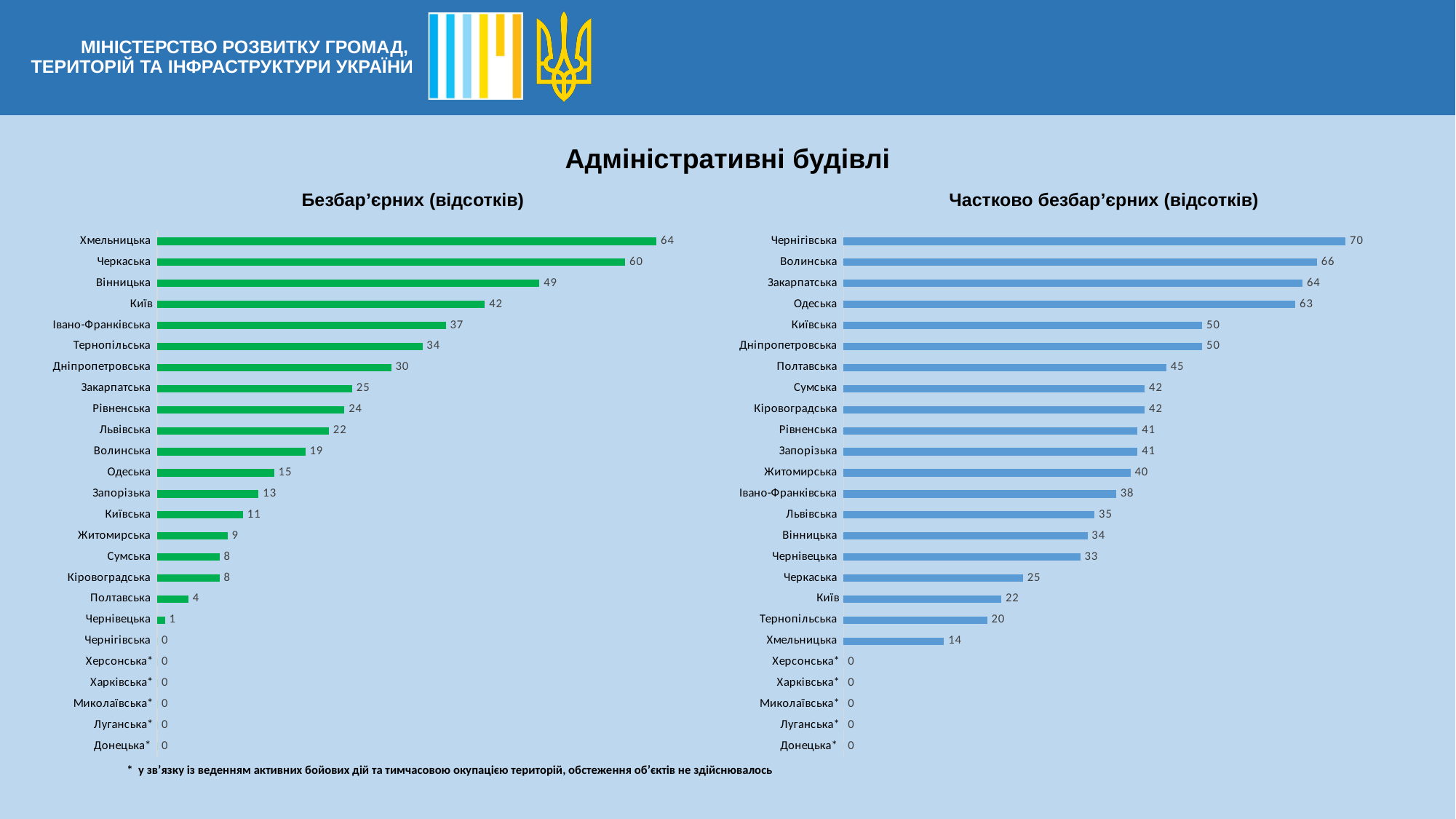
In the right chart "Частково безбар’єрних (відсотків)", what is the value for Полтавська? 45 In the right chart "Частково безбар’єрних (відсотків)", what is the difference between the values for Чернігівська and Волинська? 4 In the left chart "Безбар’єрних (відсотків)", which category has the highest value? Хмельницька How many categories are shown in the left chart "Безбар’єрних (відсотків)"? 25 What is the main title of the slide above the two charts? Адміністративні будівлі In the right chart "Частково безбар’єрних (відсотків)", which category has the highest value? Чернігівська In the left chart "Безбар’єрних (відсотків)", what is the value for Чернівецька? 1 In the left chart "Безбар’єрних (відсотків)", what is the difference between the values for Хмельницька and Черкаська? 4 In the left chart "Безбар’єрних (відсотків)", which is larger, the value for Київ or the value for Тернопільська? Київ In the left chart "Безбар’єрних (відсотків)", what is the value for Вінницька? 49 In the right chart "Частково безбар’єрних (відсотків)", which is larger, the value for Львівська or the value for Черкаська? Львівська What kind of chart is the right chart "Частково безбар’єрних (відсотків)"? Bar chart